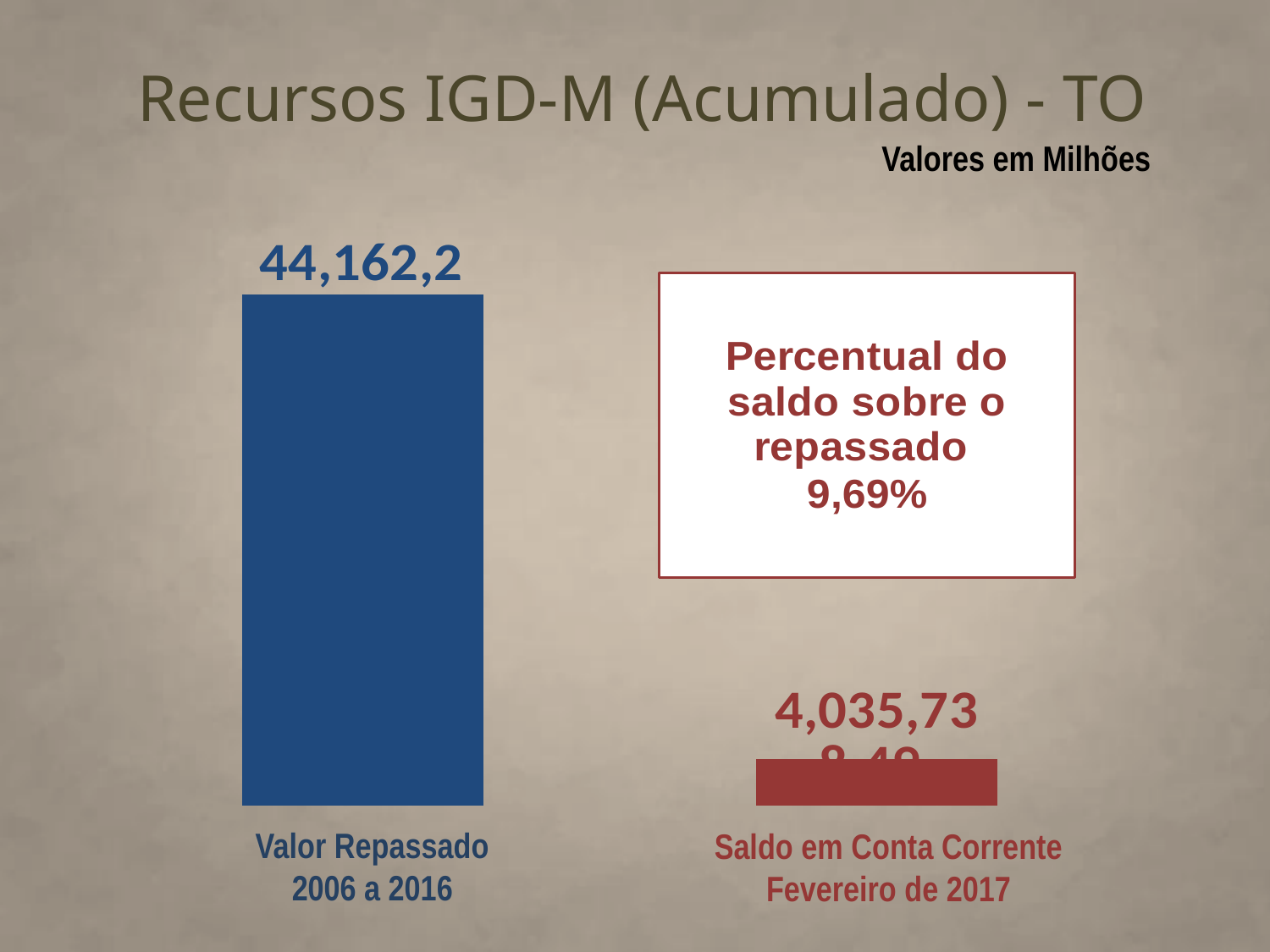
Which category has the lowest value in the chart? Saldo em Conta Corrente Fevereiro de 2017 Which category has the highest value in the chart? Valor Repassado 2006 a 2016 What is the title of the slide containing the chart? Recursos IGD-M (Acumulado) - TO How many bars does the chart show? 2 What value is printed above the bar for Valor Repassado 2006 a 2016? 44,162,2 What kind of chart is shown on the slide? bar chart What percentage is shown in the text box as 'Percentual do saldo sobre o repassado'? 9,69% Which is larger: Valor Repassado 2006 a 2016 or Saldo em Conta Corrente Fevereiro de 2017? Valor Repassado 2006 a 2016